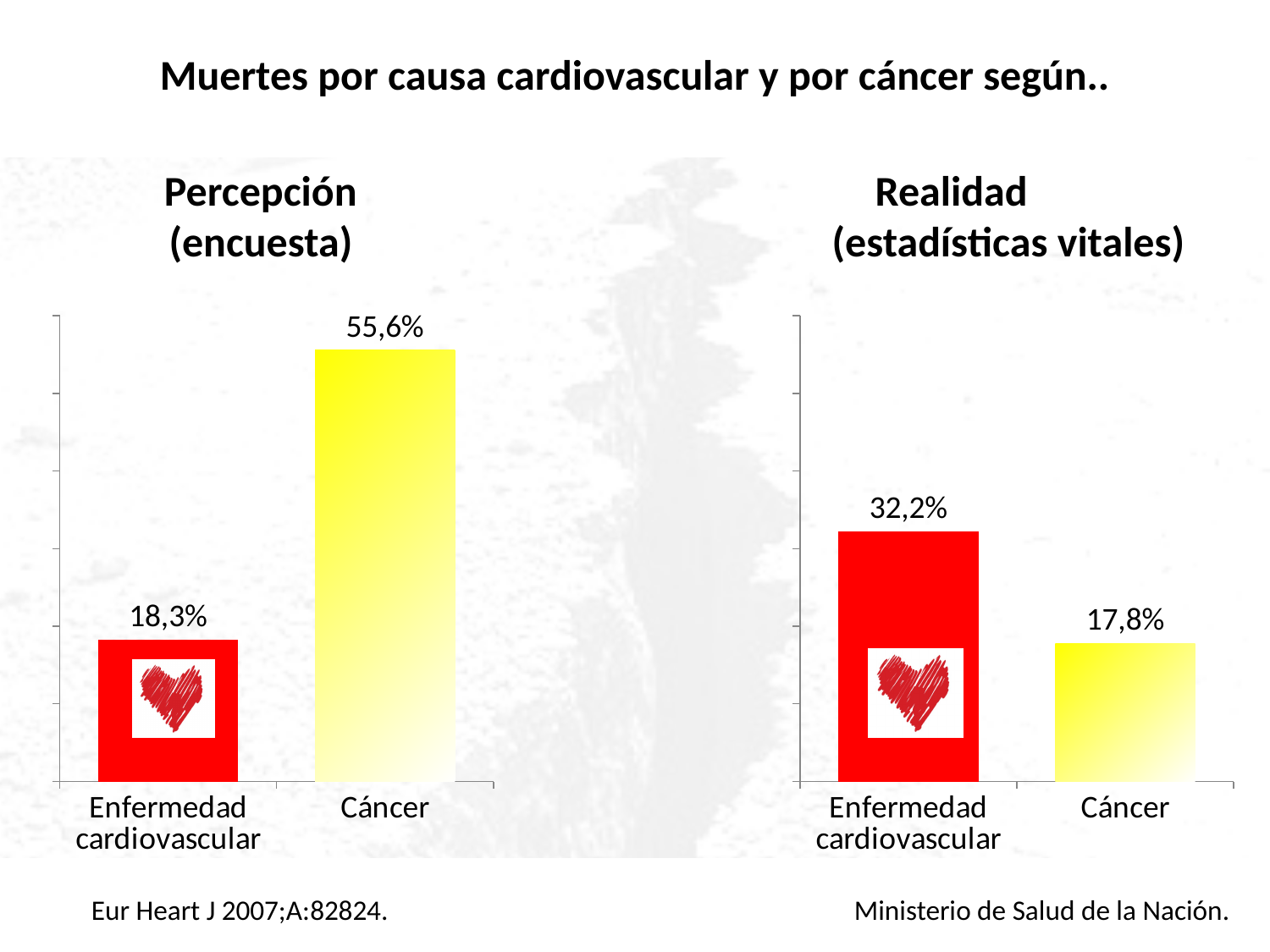
In the Realidad (estadísticas vitales) chart, what is the difference between the values for Enfermedad cardiovascular and Cáncer? 14,4% In the Percepción (encuesta) chart, what is the difference between the values for Cáncer and Enfermedad cardiovascular? 37,3% In the Realidad (estadísticas vitales) chart, which is larger: Enfermedad cardiovascular or Cáncer? Enfermedad cardiovascular In the Percepción (encuesta) chart, which category has the highest value? Cáncer What is the title of the slide above the two charts? Muertes por causa cardiovascular y por cáncer según.. In the Percepción (encuesta) chart, what is the value for Enfermedad cardiovascular? 18,3% In the Realidad (estadísticas vitales) chart, what is the value for Cáncer? 17,8% In the Realidad (estadísticas vitales) chart, which category has the lowest value? Cáncer How many categories does the Percepción (encuesta) chart show? 2 What kind of chart is the Realidad (estadísticas vitales) chart? Bar chart In the Percepción (encuesta) chart, what is the value for Cáncer? 55,6% In the Realidad (estadísticas vitales) chart, what is the value for Enfermedad cardiovascular? 32,2%